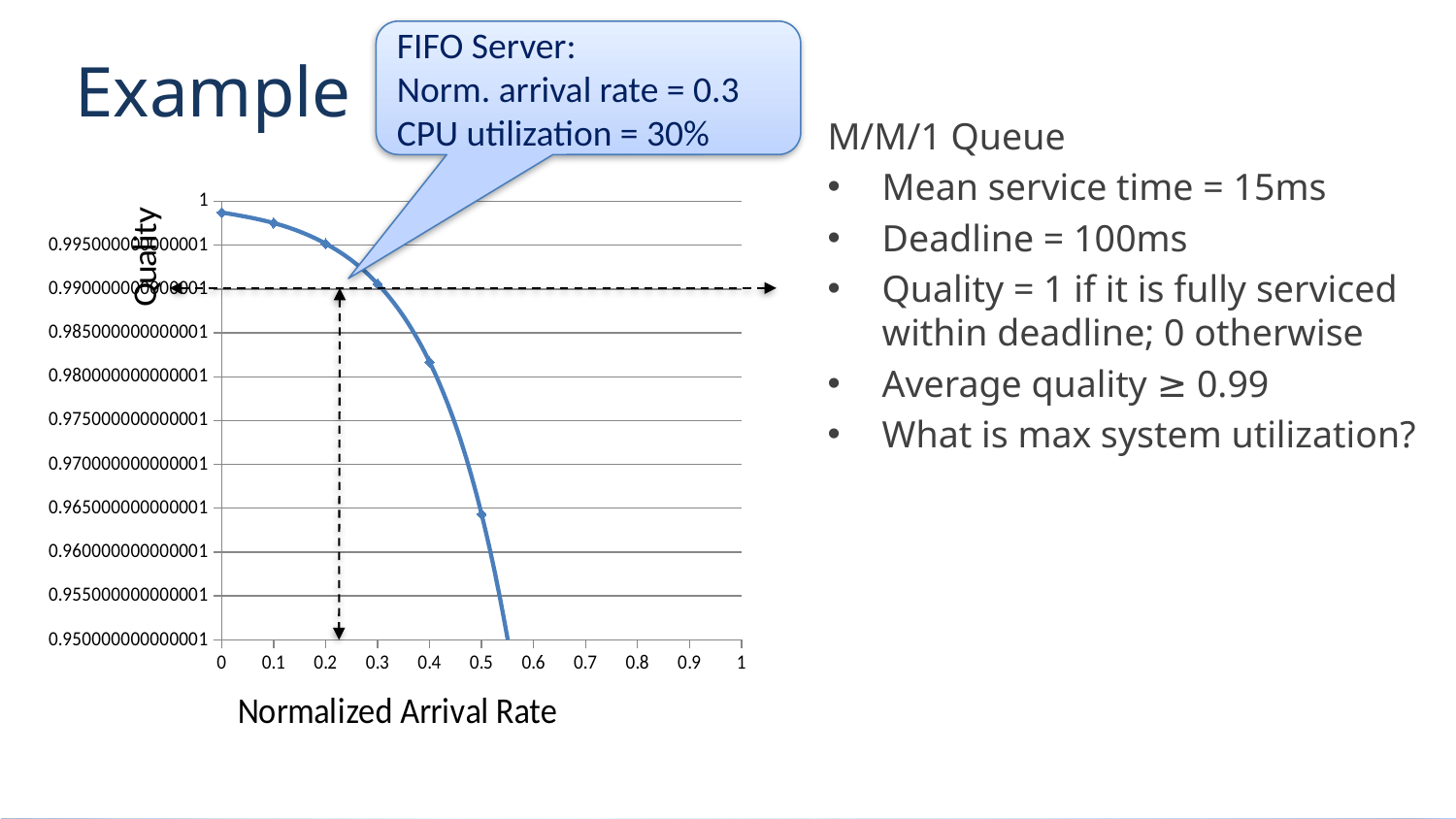
Is the quality at normalized arrival rate 0.4 greater or less than 0.975? greater What is the title of the x axis of the chart? Normalized Arrival Rate Is the quality at normalized arrival rate 0.1 greater or less than 0.995? greater What kind of chart is shown on the slide? line chart Is the quality at normalized arrival rate 0.4 greater or less than 0.985? less What is the title of the y axis of the chart? Quality As the normalized arrival rate increases along the x axis, does the quality rise or fall? fall Which has the higher quality: normalized arrival rate 0.1 or 0.5? 0.1 At which normalized arrival rate is the plotted quality highest? 0